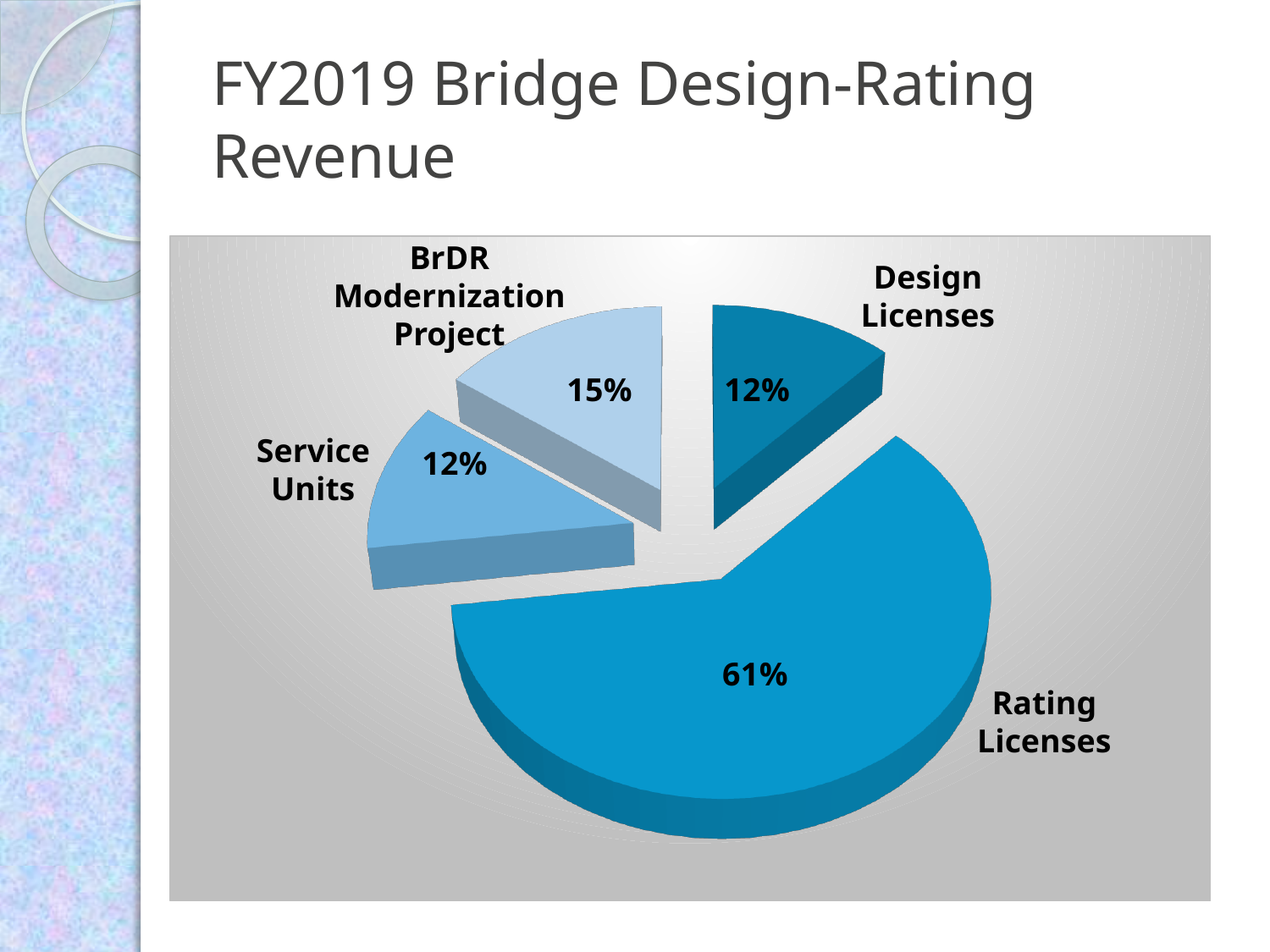
What is the difference in percentage points between Rating Licenses and the BrDR Modernization Project? 46 What is the combined share of Design Licenses and Service Units? 24% Which slice is shown in the lightest blue colour? BrDR Modernization Project Which is larger, the share for the BrDR Modernization Project or the share for Design Licenses? BrDR Modernization Project How many slices does the pie chart have? 4 Which category has the largest share of revenue? Rating Licenses What share of revenue comes from Rating Licenses? 61% What share of revenue comes from Design Licenses? 12% What is the title of the slide containing the chart? FY2019 Bridge Design-Rating Revenue What share of revenue comes from the BrDR Modernization Project? 15% What share of revenue comes from Service Units? 12% What kind of chart is shown on the slide? pie chart